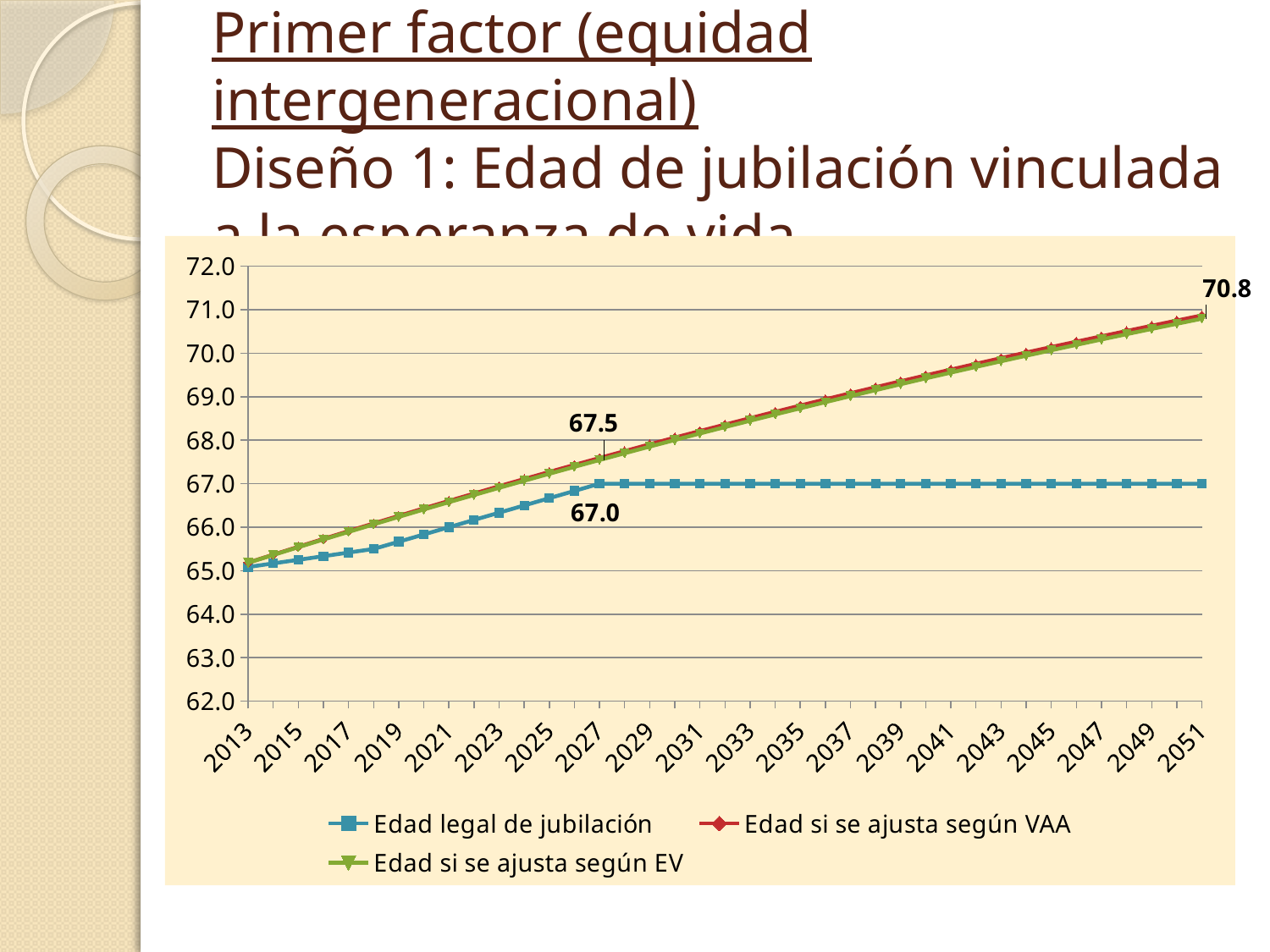
Is the value for 'Edad legal de jubilación' in 2051 greater or less than 68.0? less What is the difference between the two labelled values in 2027 (67.5 and 67.0)? 0.5 Is the value for 'Edad legal de jubilación' in 2013 greater or less than 66.0? less What is the value of 'Edad legal de jubilación' in 2027? 67.0 Which series is drawn with blue square markers? Edad legal de jubilación Does the 'Edad si se ajusta según VAA' series rise or fall from 2013 to 2051? rise In 2045, which series is higher: 'Edad legal de jubilación' or 'Edad si se ajusta según VAA'? Edad si se ajusta según VAA Is the value for 'Edad si se ajusta según EV' in 2051 greater or less than 70.0? greater How many series does the chart legend list? 3 What are the first and last years shown on the x axis? 2013 and 2051 What is the highest value labelled on the chart, reached in 2051? 70.8 What type of chart is shown on the slide? line chart